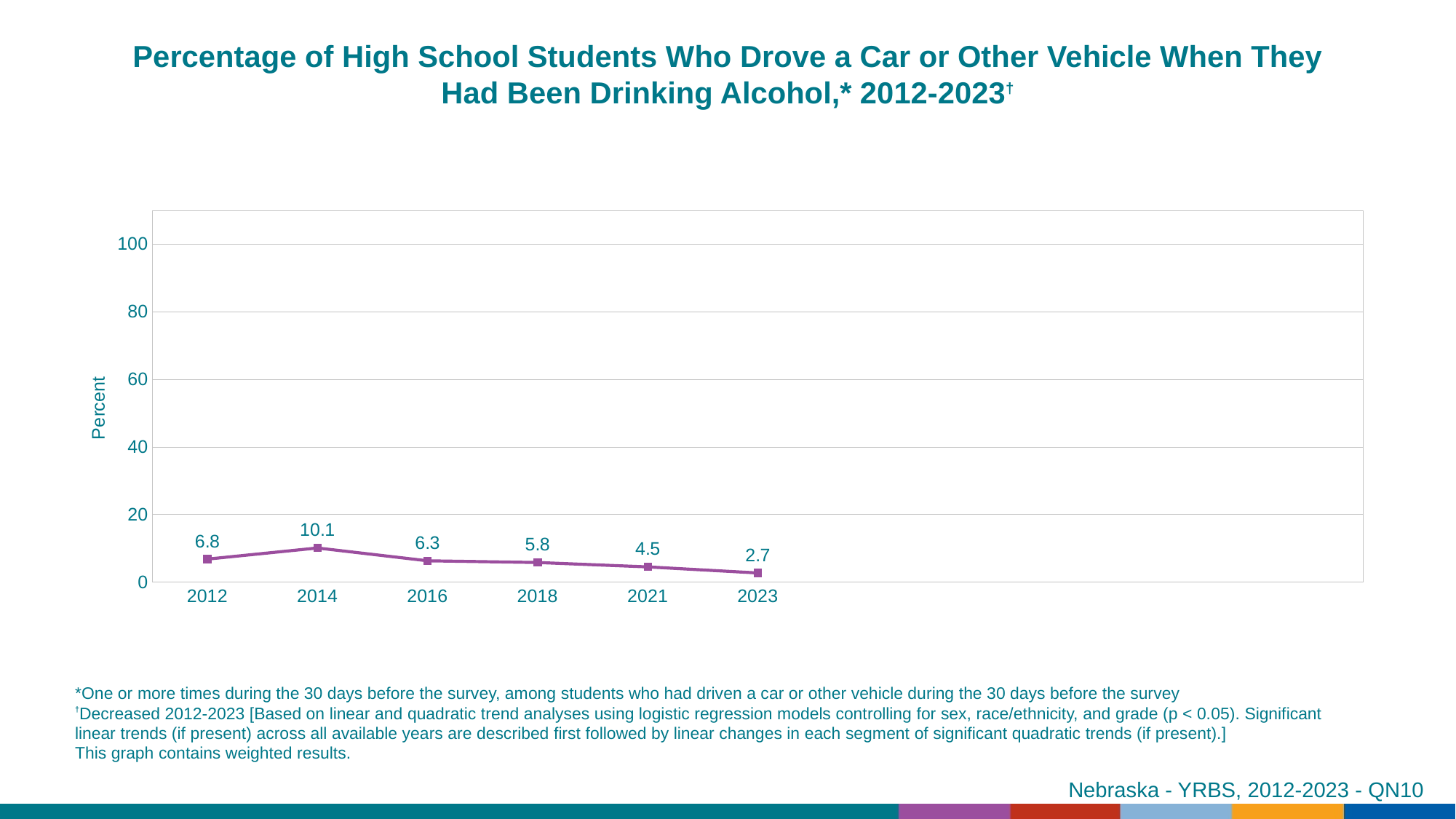
Which year has the highest value? 2014 What is the label on the y axis? Percent What is the difference between the values for 2014 and 2023? 7.4 What kind of chart is shown on the slide? line chart What is the value for 2021? 4.5 What is the value for 2023? 2.7 How many years are plotted on the chart? 6 What is the value for 2012? 6.8 Which year has the lowest value? 2023 Which is larger, the value for 2016 or the value for 2018? 2016 What is the value for 2014? 10.1 Is the value for 2014 greater or less than 20? less